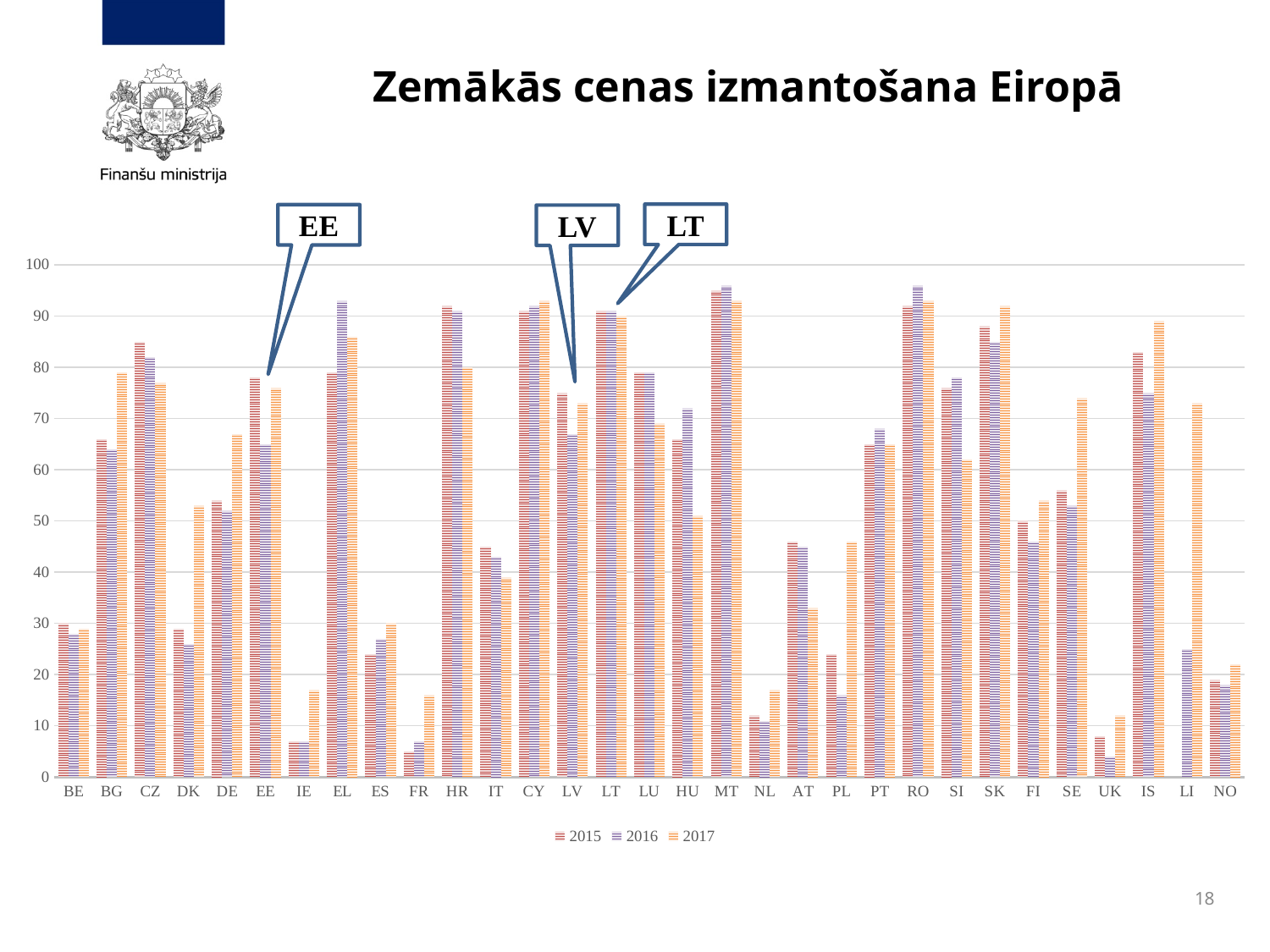
What kind of chart is shown on the slide? bar chart Is the 2017 value for IS greater or less than 80? greater Which three countries are highlighted with callout labels above the chart? EE, LV, LT Which country has the lowest 2016 value? UK Which is larger, the 2015 value for LT or the 2015 value for LV? LT How many series does the legend list? 3 Is the 2015 value for EE greater or less than 70? greater Is the 2016 value for PL greater or less than 20? less Which is larger, the 2017 value for PL or the 2016 value for PL? 2017 What is the title of the chart on the slide? Zemākās cenas izmantošana Eiropā How many countries are shown on the x axis of the chart? 31